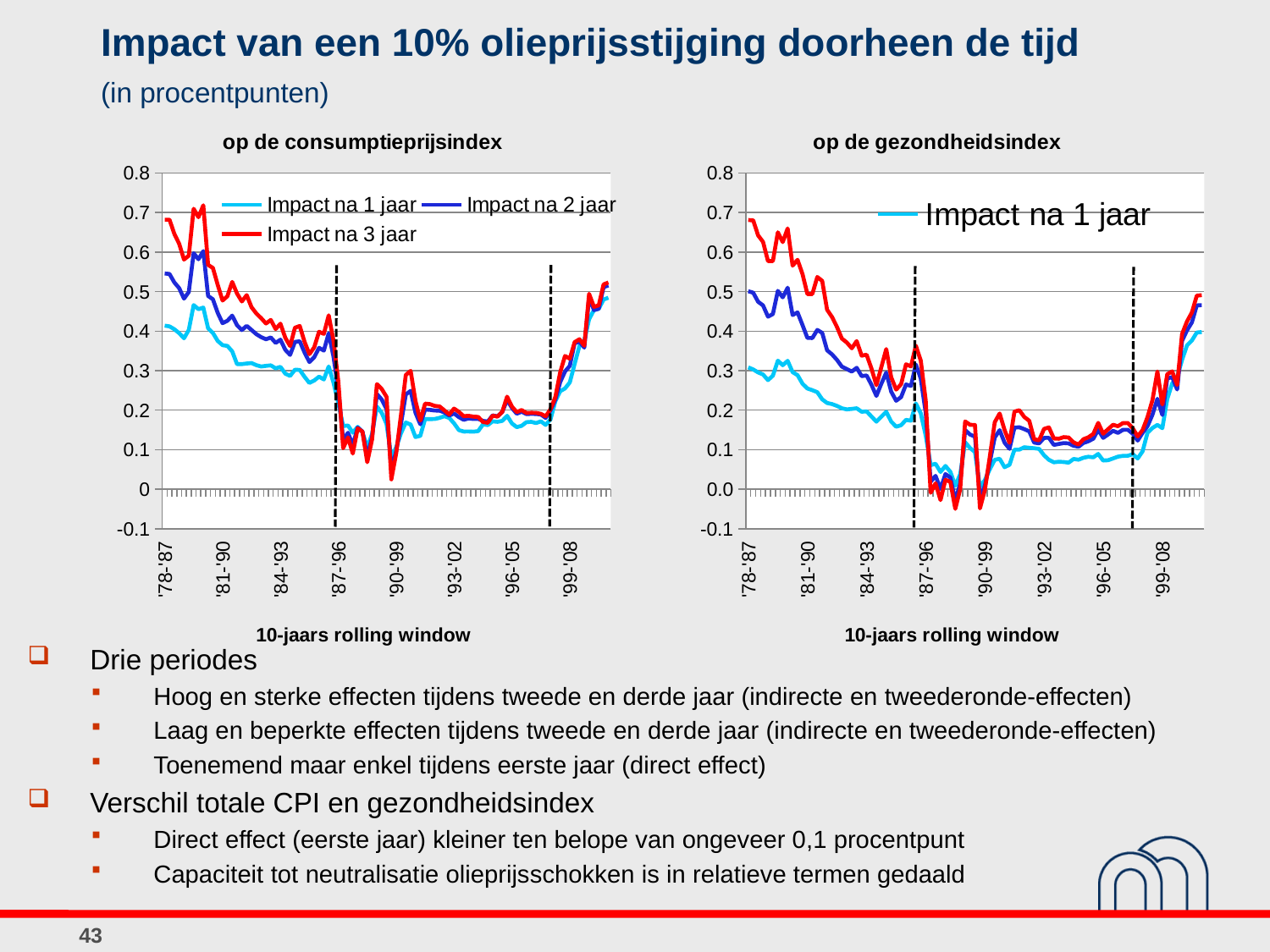
In the chart titled 'op de consumptieprijsindex', is the value of 'Impact na 3 jaar' at '78-'87 greater or less than 0.6? greater How many series does the legend list in the chart titled 'op de gezondheidsindex'? 1 In the chart titled 'op de consumptieprijsindex', which is larger at '78-'87: 'Impact na 3 jaar' or 'Impact na 1 jaar'? Impact na 3 jaar What kind of chart is the chart titled 'op de consumptieprijsindex'? line chart In the chart titled 'op de gezondheidsindex', is the value of 'Impact na 1 jaar' at '78-'87 greater or less than 0.4? less In the chart titled 'op de consumptieprijsindex', is the value of 'Impact na 1 jaar' at '78-'87 greater or less than 0.3? greater What is the x-axis label below the chart titled 'op de consumptieprijsindex'? 10-jaars rolling window What colour is the 'Impact na 1 jaar' line in the chart titled 'op de consumptieprijsindex'? light blue In the chart titled 'op de gezondheidsindex', does 'Impact na 1 jaar' rise or fall between '96-'05 and '99-'08? rise How many x-axis tick labels are shown on the chart titled 'op de gezondheidsindex'? 8 How many series does the legend list in the chart titled 'op de consumptieprijsindex'? 3 In the chart titled 'op de consumptieprijsindex', does 'Impact na 3 jaar' rise or fall between '78-'87 and '87-'96? fall